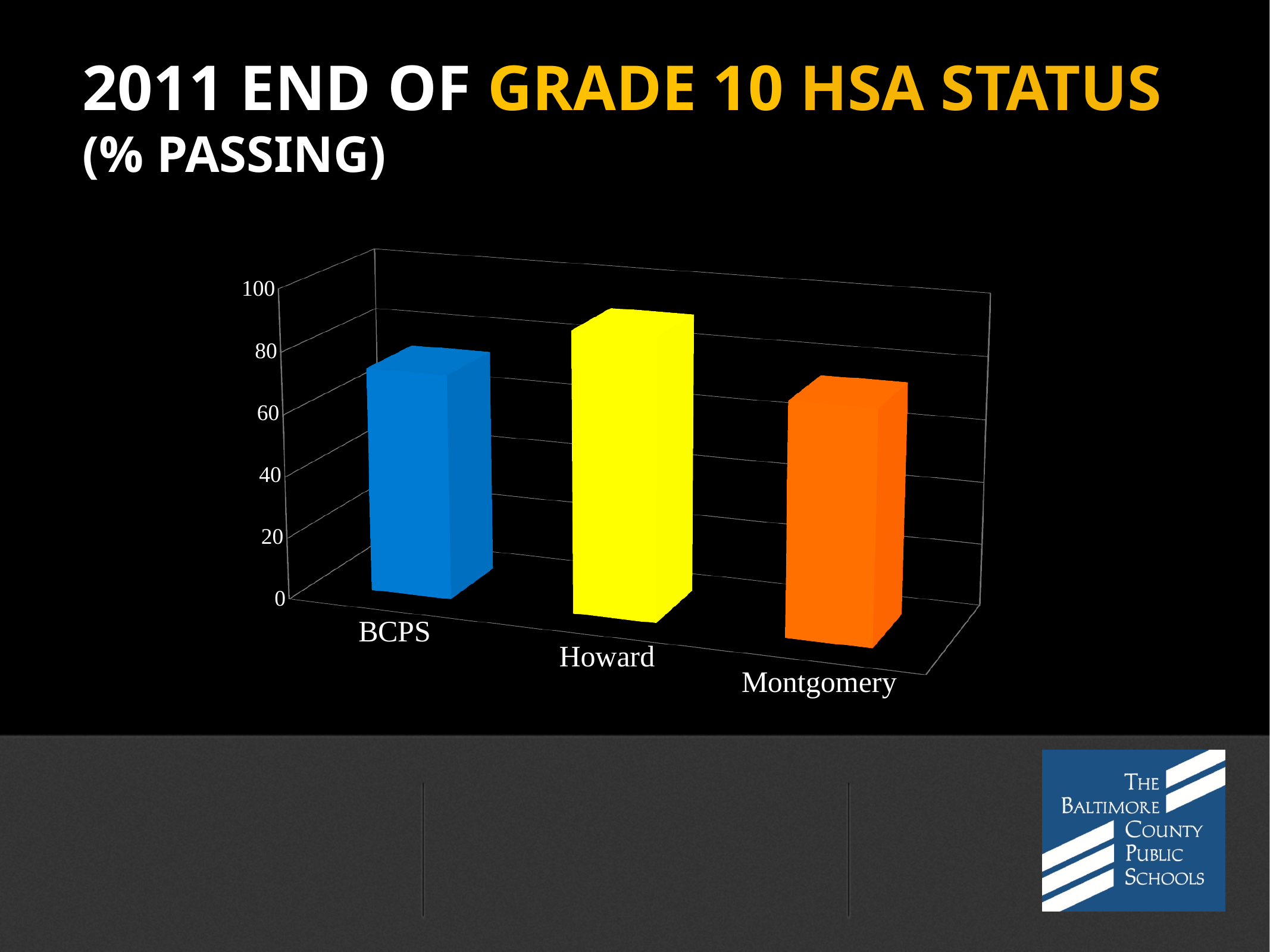
Is the value for Montgomery greater or less than 80? less Which is larger, the value for Howard or the value for BCPS? Howard Is the value for Montgomery greater or less than 40? greater What kind of chart is shown on the slide? bar chart What is the title of the slide containing the chart? 2011 END OF GRADE 10 HSA STATUS (% PASSING) How many categories are shown on the x axis of the chart? 3 Is the value for Howard greater or less than 60? greater What colour is the bar for Howard? yellow Which category has the highest value in the chart? Howard